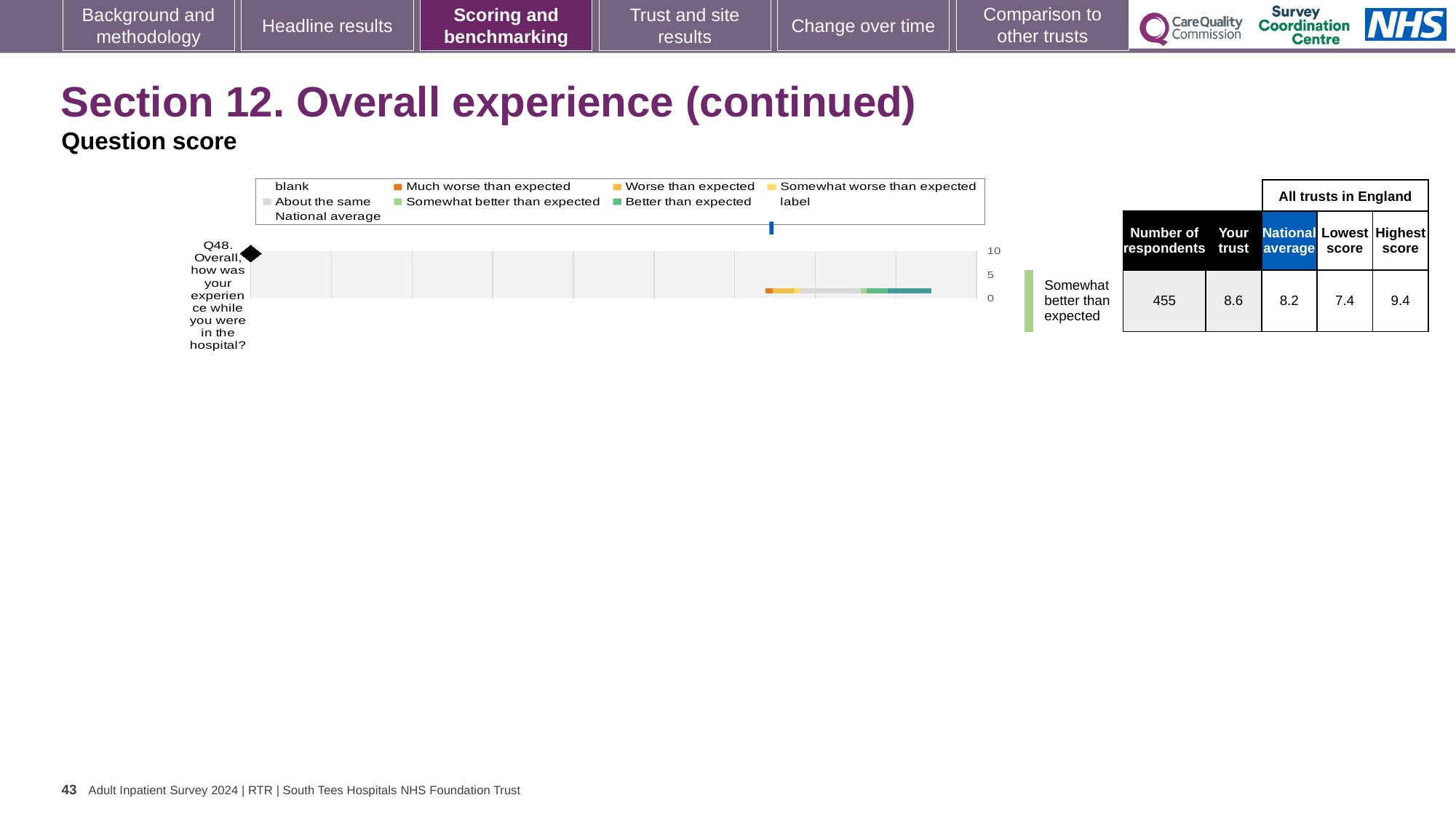
What benchmarking category is Q48 assigned to on the slide? Somewhat better than expected Which legend entry is shown in orange on the chart? Much worse than expected In the table beside the chart, what is the lowest score among all trusts in England for Q48? 7.4 In the table beside the chart, what is the national average score for Q48? 8.2 What kind of chart is used to show the Q48 question score? bar chart What is the highest value shown on the chart's score axis? 10 In the table beside the chart, what is the highest score among all trusts in England for Q48? 9.4 Which is larger for Q48: the 'Your trust' score or the national average? Your trust In the table beside the chart, what is the 'Your trust' score for Q48? 8.6 What is the difference between the 'Your trust' score and the national average for Q48? 0.4 How many questions are plotted on the chart? 1 In the table beside the chart, what is the number of respondents for Q48? 455